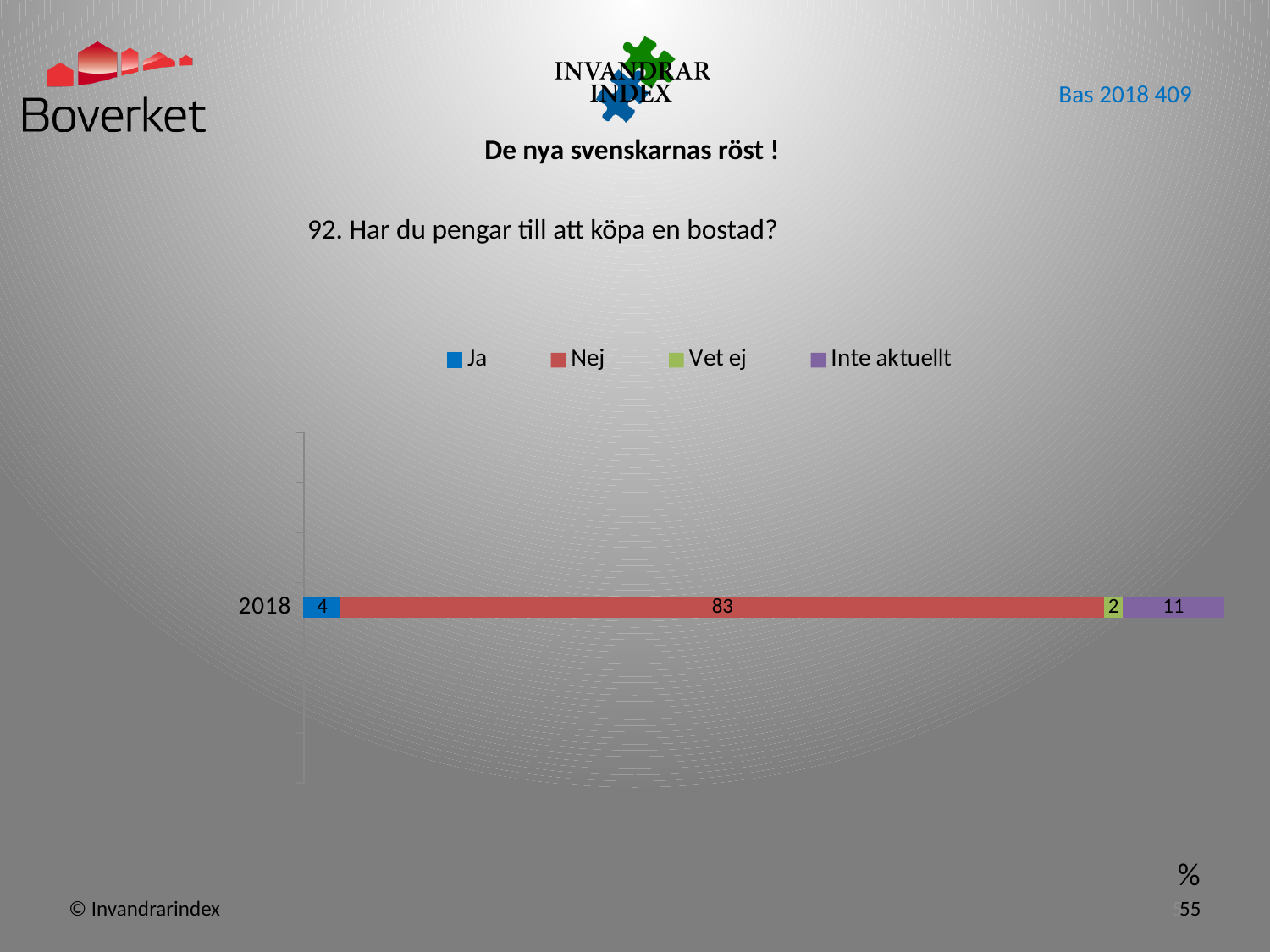
Which is larger in 2018, Ja or Inte aktuellt? Inte aktuellt What is the value for Ja in 2018? 4 What kind of chart is shown on the slide? Stacked bar chart What is the value for Nej in 2018? 83 What is the difference between the values for Nej and Inte aktuellt in 2018? 72 Which series has the highest value in 2018? Nej What is the value for Inte aktuellt in 2018? 11 How many series does the legend list? 4 What is the value for Vet ej in 2018? 2 What colour represents Nej in the chart? Red What is the total of the stacked bar for 2018? 100 Which series has the lowest value in 2018? Vet ej